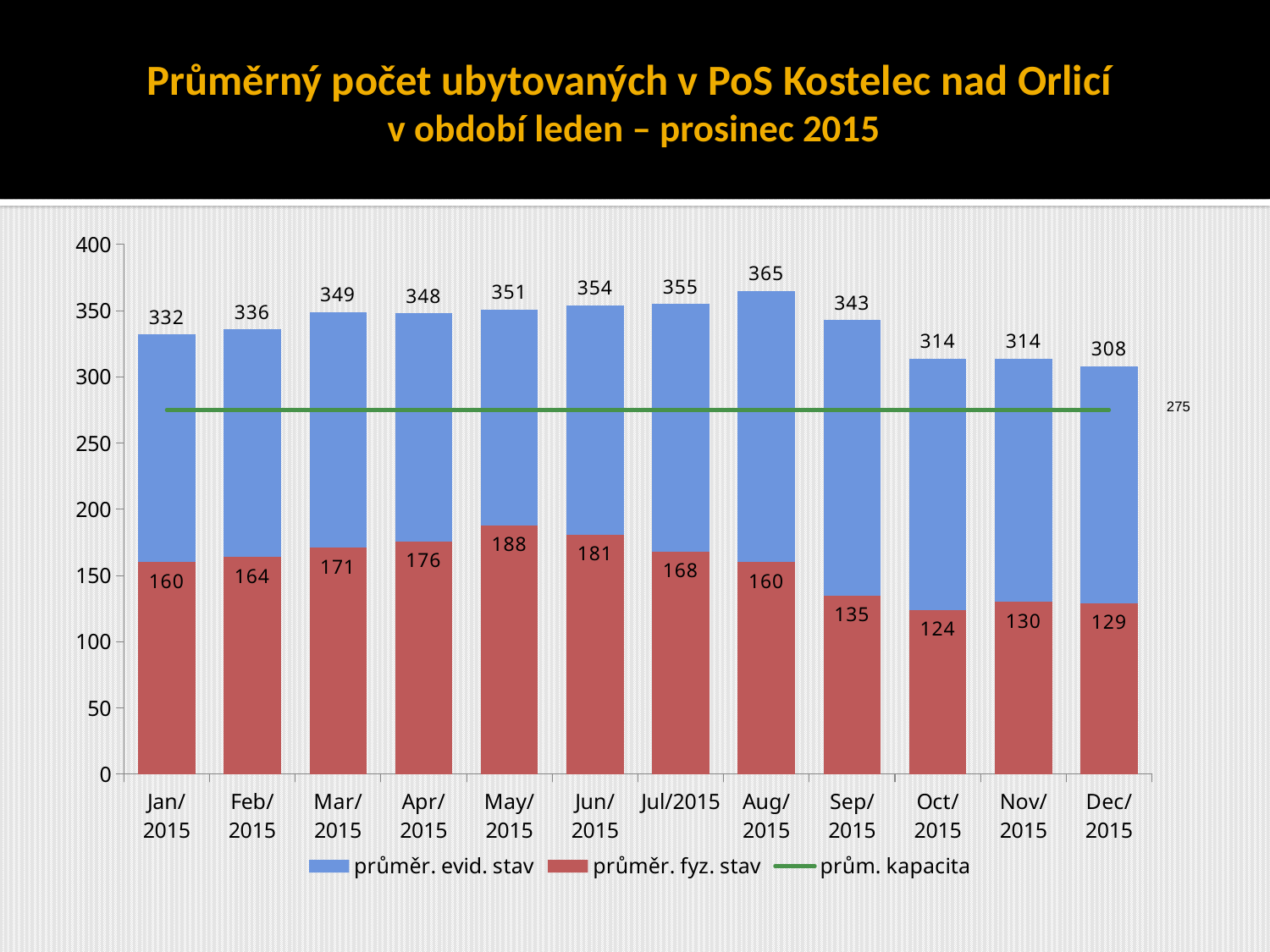
How many months are shown on the x axis? 12 What is the value of průměr. evid. stav for Aug/2015? 365 Which month has the highest průměr. evid. stav value? Aug/2015 Is the průměr. evid. stav value for Dec/2015 greater or less than 300? greater How many series does the legend list? 3 Which series is shown in red? průměr. fyz. stav Which month has the lowest průměr. fyz. stav value? Oct/2015 Which is larger, the průměr. fyz. stav value for Jun/2015 or for Sep/2015? Jun/2015 What is the difference between the průměr. evid. stav values for Aug/2015 and Dec/2015? 57 What value does the prům. kapacita line show? 275 What is the value of průměr. fyz. stav for May/2015? 188 What kind of chart is shown on the slide? bar chart with a line